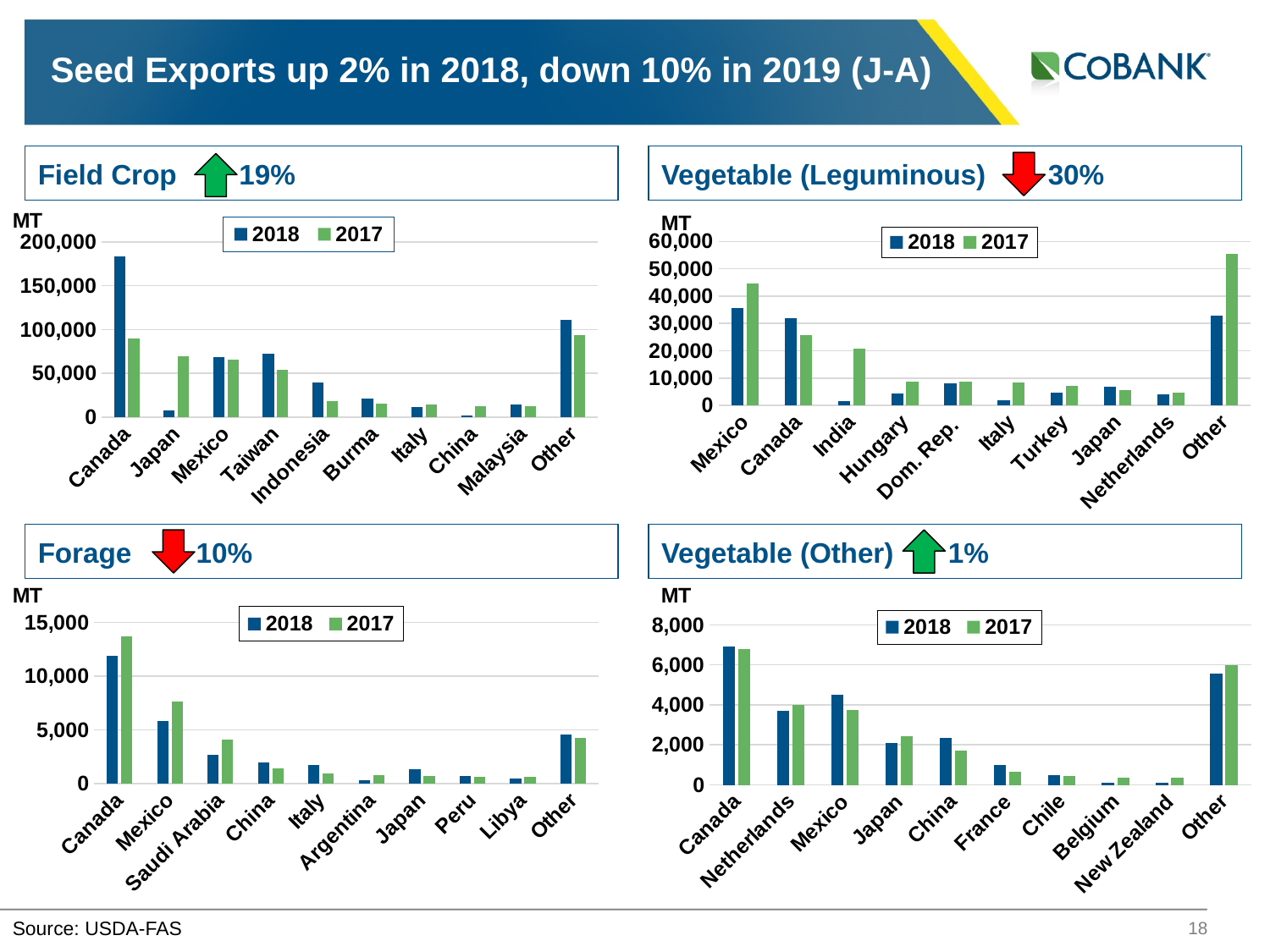
In the Field Crop chart, is the 2018 value for Canada greater or less than 150,000? greater In the Vegetable (Leguminous) chart, which is larger for India, the 2018 value or the 2017 value? 2017 How many countries/categories are shown on the x axis of the Field Crop chart? 10 What kind of chart is the Vegetable (Other) chart? bar chart In the Vegetable (Leguminous) chart, is the 2017 value for Other greater or less than 50,000? greater In the Vegetable (Other) chart, is the 2018 value for Canada greater or less than 6,000? greater How many series does the legend list in the Vegetable (Leguminous) chart? 2 In the Field Crop chart, which country has the highest 2018 value? Canada What unit is shown on the y axis of the Forage chart? MT In the Forage chart, which country has the highest 2017 value? Canada In the Field Crop chart, which is larger for Japan, the 2018 value or the 2017 value? 2017